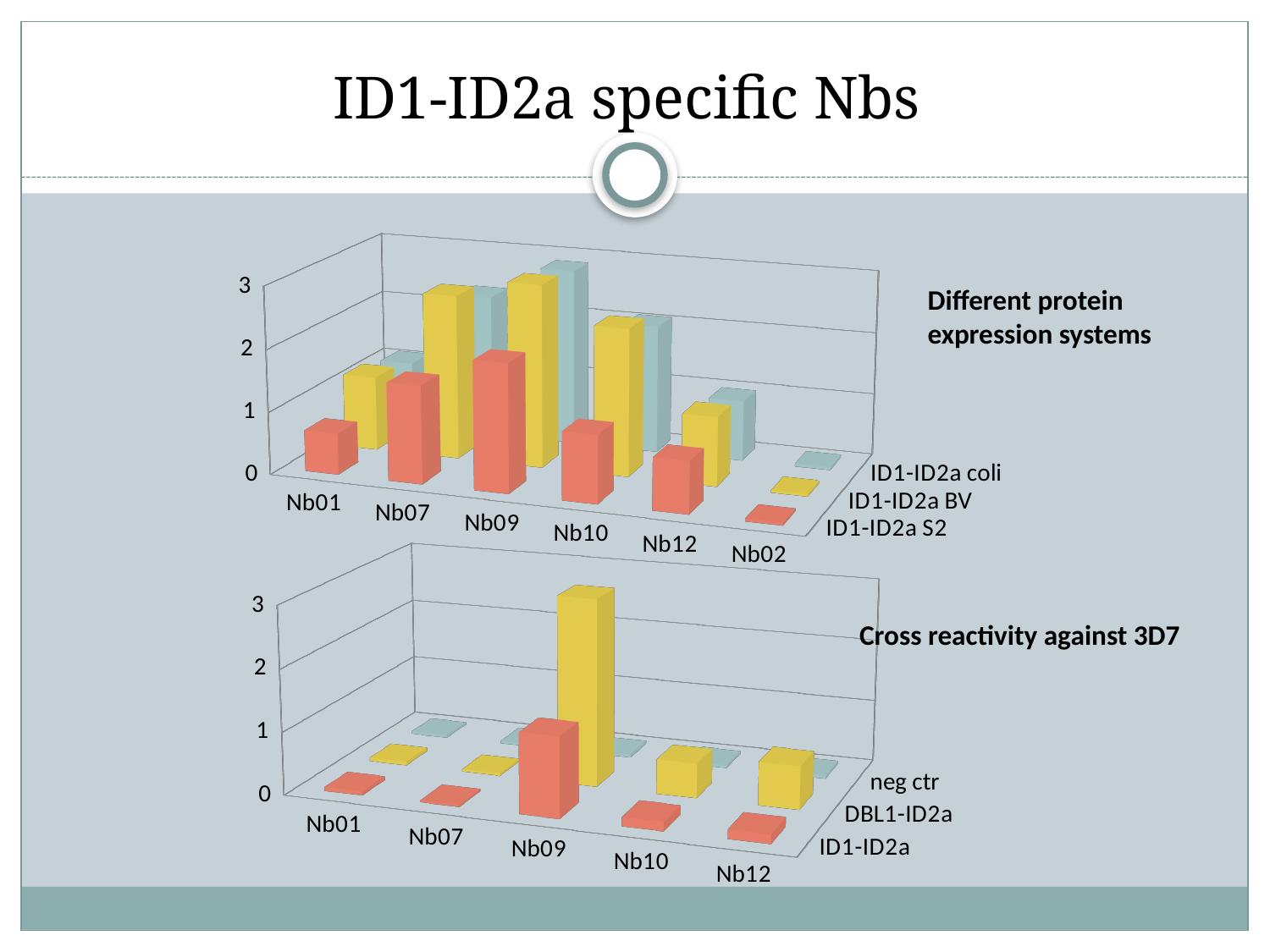
In the 'Different protein expression systems' chart, which category has the highest ID1-ID2a S2 value? Nb09 In the 'Cross reactivity against 3D7' chart, is the ID1-ID2a value for Nb01 greater or less than 1? less What are the three series names listed on the 'Cross reactivity against 3D7' chart? neg ctr, DBL1-ID2a, ID1-ID2a How many series does the 'Different protein expression systems' chart show? 3 In the 'Different protein expression systems' chart, is the ID1-ID2a BV value for Nb02 greater or less than 1? less In the 'Different protein expression systems' chart, which is larger, the ID1-ID2a S2 value for Nb09 or for Nb02? Nb09 How many categories are shown on the x axis of the 'Cross reactivity against 3D7' chart? 5 What kind of chart is the 'Different protein expression systems' chart? bar chart In the 'Cross reactivity against 3D7' chart, is the DBL1-ID2a value for Nb09 greater or less than 2? greater How many categories are shown on the x axis of the 'Different protein expression systems' chart? 6 In the 'Cross reactivity against 3D7' chart, which category has the highest DBL1-ID2a value? Nb09 In the 'Different protein expression systems' chart, which category has the lowest values across all three series? Nb02